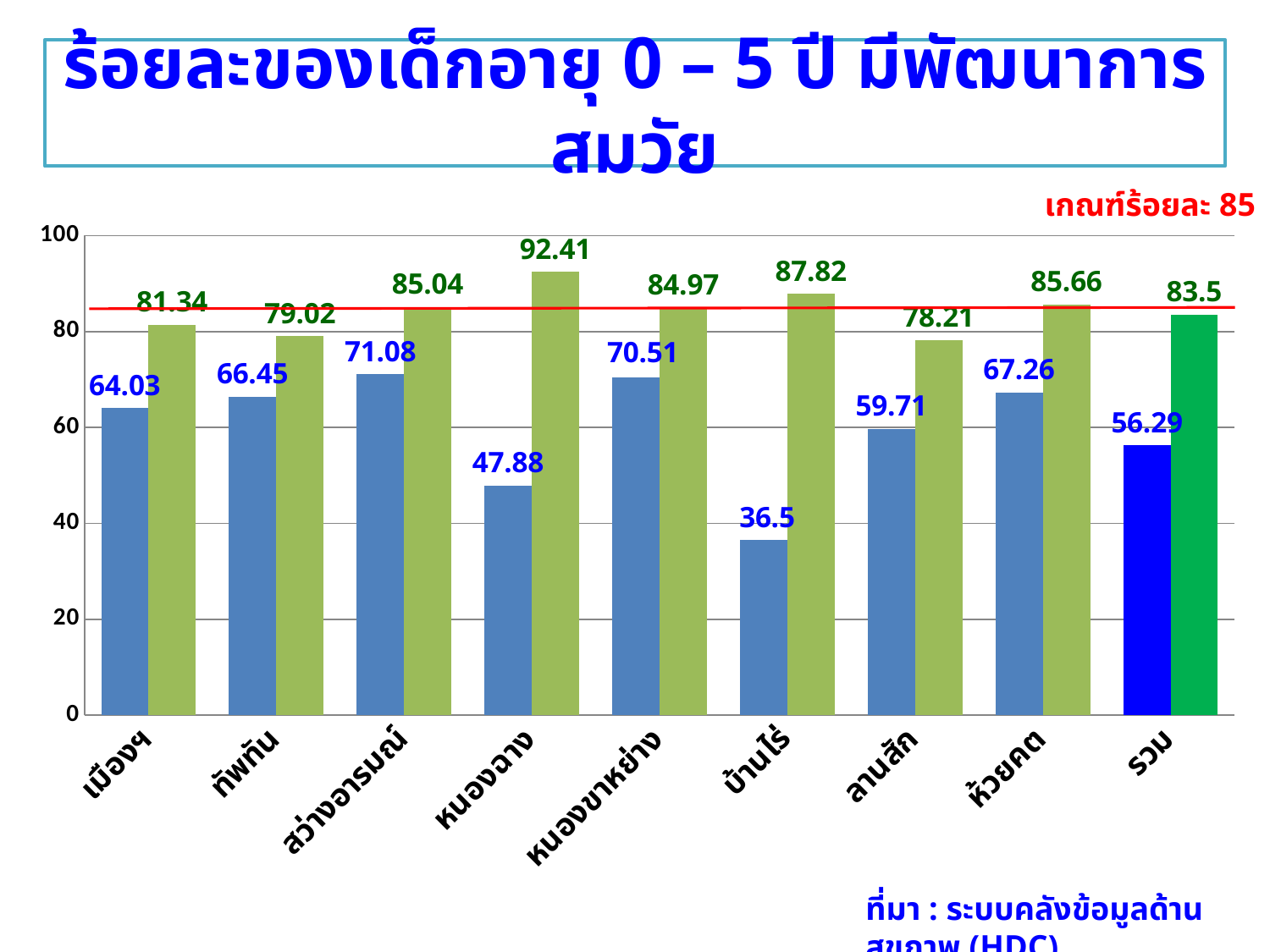
Which category has the highest green bar? หนองฉาง Which category has the lowest blue bar? บ้านไร่ Is the green bar for ลานสัก greater or less than 80? less Which is larger, the blue bar for สว่างอารมณ์ or the blue bar for ทัพทัน? สว่างอารมณ์ How many categories are shown on the x axis? 9 What is the value of the blue bar for ห้วยคต? 67.26 What type of chart is shown on the slide? bar chart What threshold value does the red horizontal line represent, as labelled on the slide? เกณฑ์ร้อยละ 85 What is the value of the green bar for บ้านไร่? 87.82 What is the value of the green bar for รวม? 83.5 What is the value of the blue bar for หนองฉาง? 47.88 What is the difference between the green bar and the blue bar for บ้านไร่? 51.32